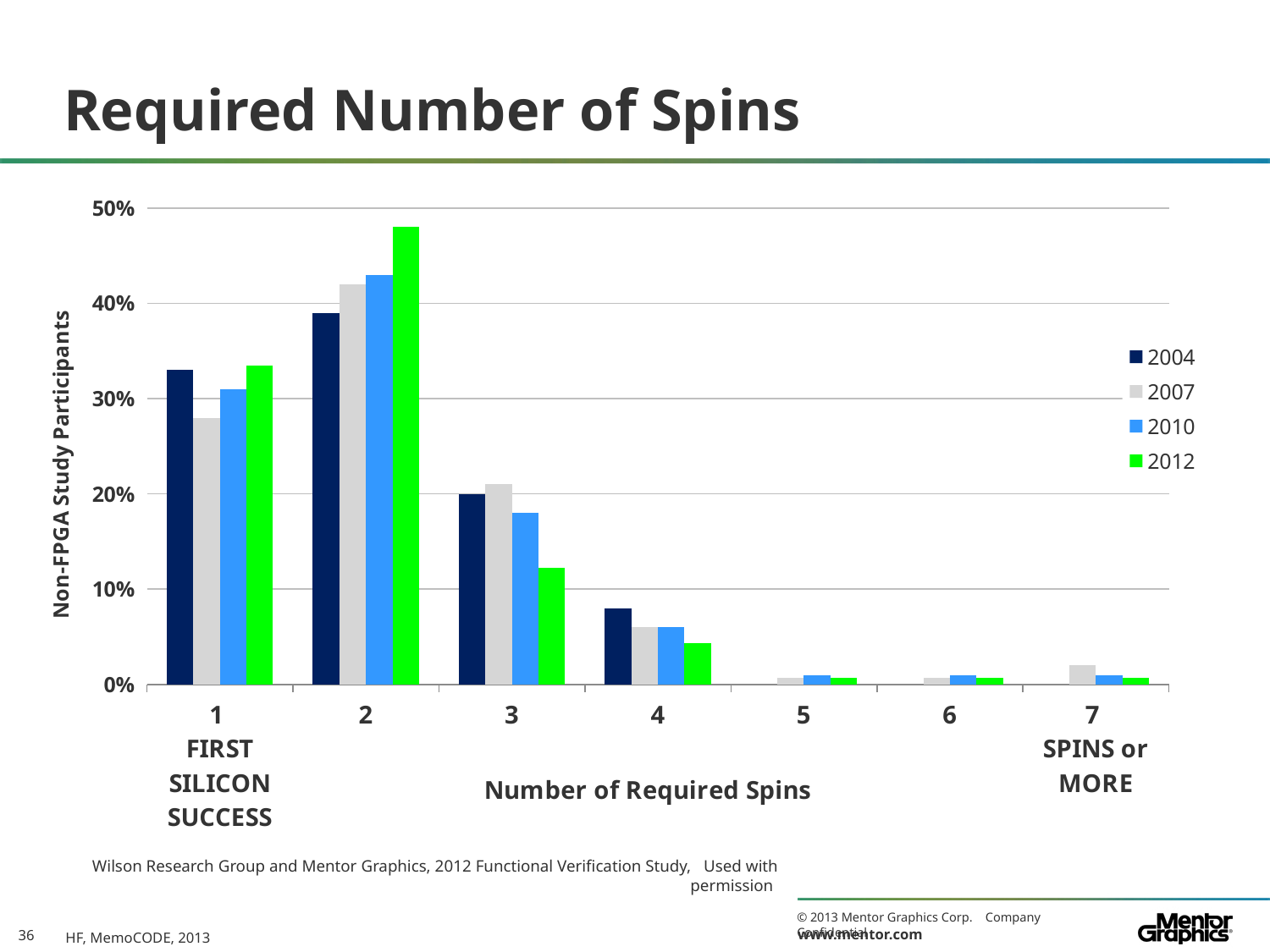
Which number of required spins has the highest value for the 2004 series? 2 How many categories are shown along the x axis? 7 Is the value for 2012 at 2 spins greater or less than 40%? greater Which number of required spins has the highest value for the 2012 series? 2 At 2 spins, which series has the larger value, 2004 or 2012? 2012 How many series does the legend list? 4 Is the value for 2004 at 4 spins greater or less than 10%? less What kind of chart is shown on the slide? bar chart Is the value for 2012 at 3 spins greater or less than 10%? greater What is the label of the vertical axis? Non-FPGA Study Participants At 3 spins, which series has the larger value, 2007 or 2012? 2007